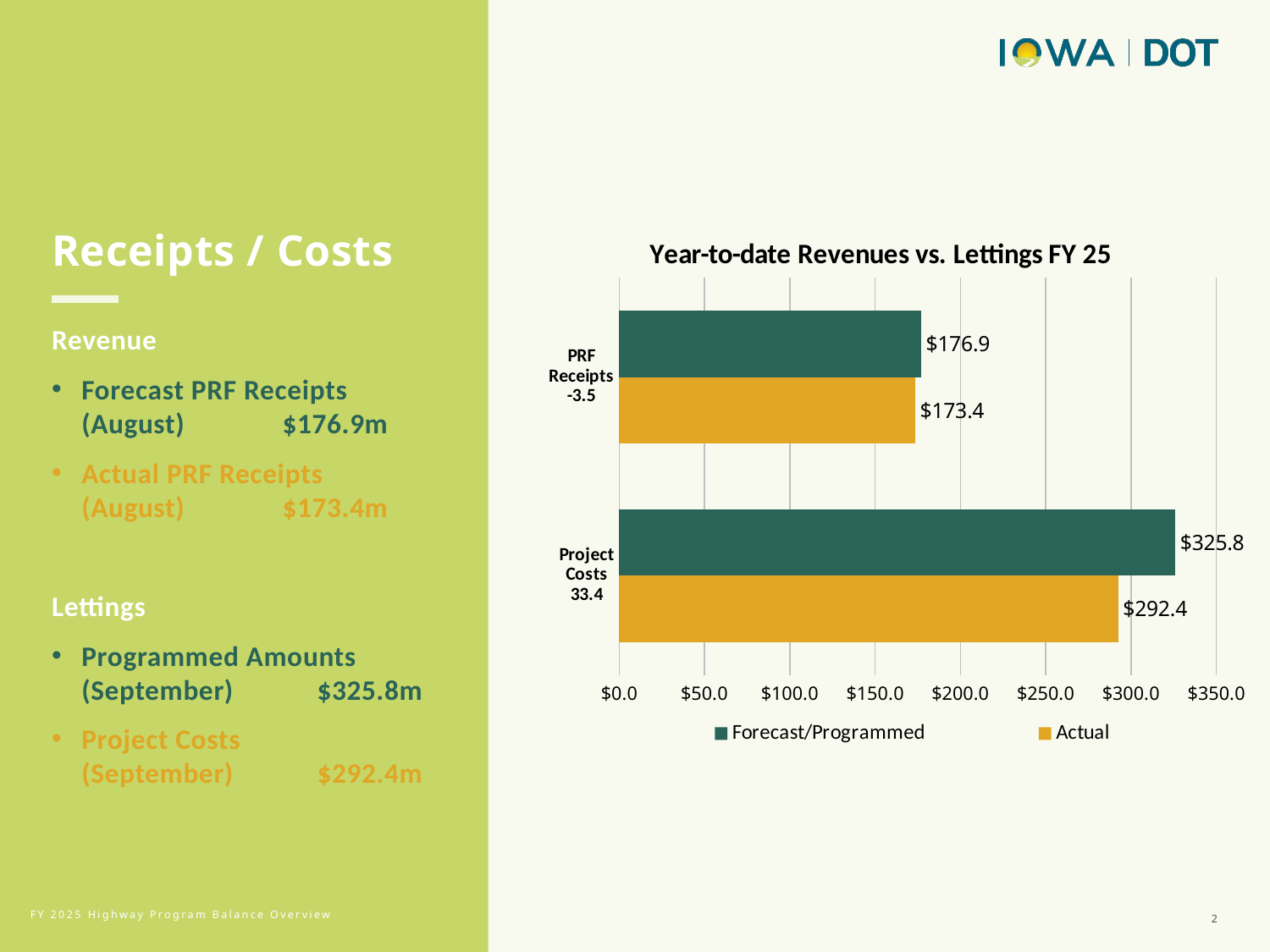
Which category has the highest Forecast/Programmed value? Project Costs How many categories are shown on the chart? 2 What is the title of the chart? Year-to-date Revenues vs. Lettings FY 25 What is the Forecast/Programmed value for PRF Receipts? $176.9 What is the Forecast/Programmed value for Project Costs? $325.8 How many series does the legend list? 2 What is the difference between the Forecast/Programmed and Actual values for Project Costs? $33.4 What kind of chart is shown on the slide? Bar chart What is the Actual value for Project Costs? $292.4 What is the Actual value for PRF Receipts? $173.4 Which category has the lowest Actual value? PRF Receipts Which is larger for PRF Receipts, the Forecast/Programmed value or the Actual value? Forecast/Programmed